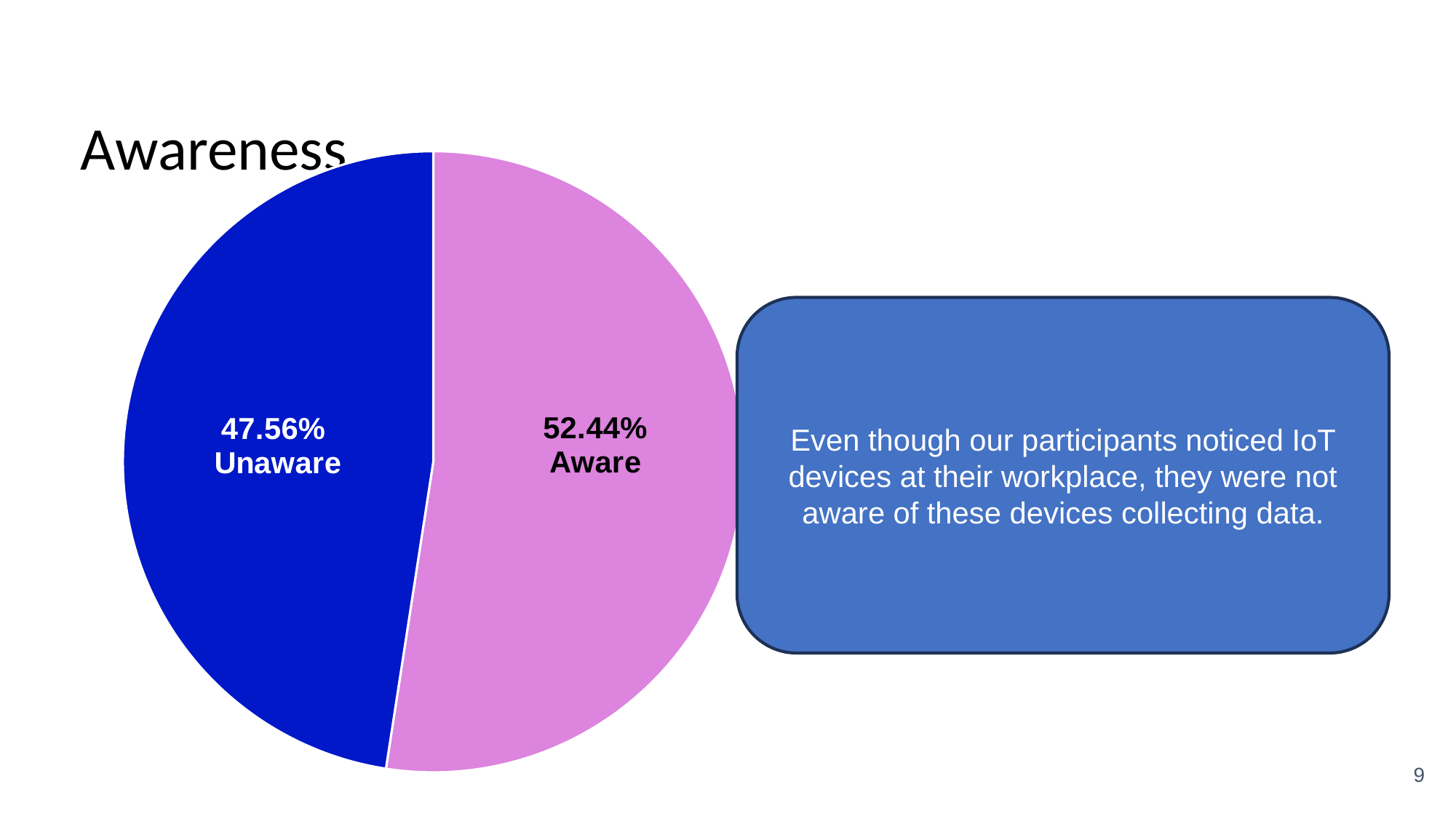
What percentage of participants were Aware? 52.44% How many slices does the pie chart have? 2 What is the difference between the Aware and Unaware percentages? 4.88% What colour is the Unaware slice? blue What percentage of participants were Unaware? 47.56% What share of the pie does the Unaware slice represent? 47.56% What colour is the Aware slice? pink Which slice of the pie is the smallest? Unaware What kind of chart is shown on the slide? pie chart Which is larger, the Aware slice or the Unaware slice? Aware Which slice of the pie is the largest? Aware